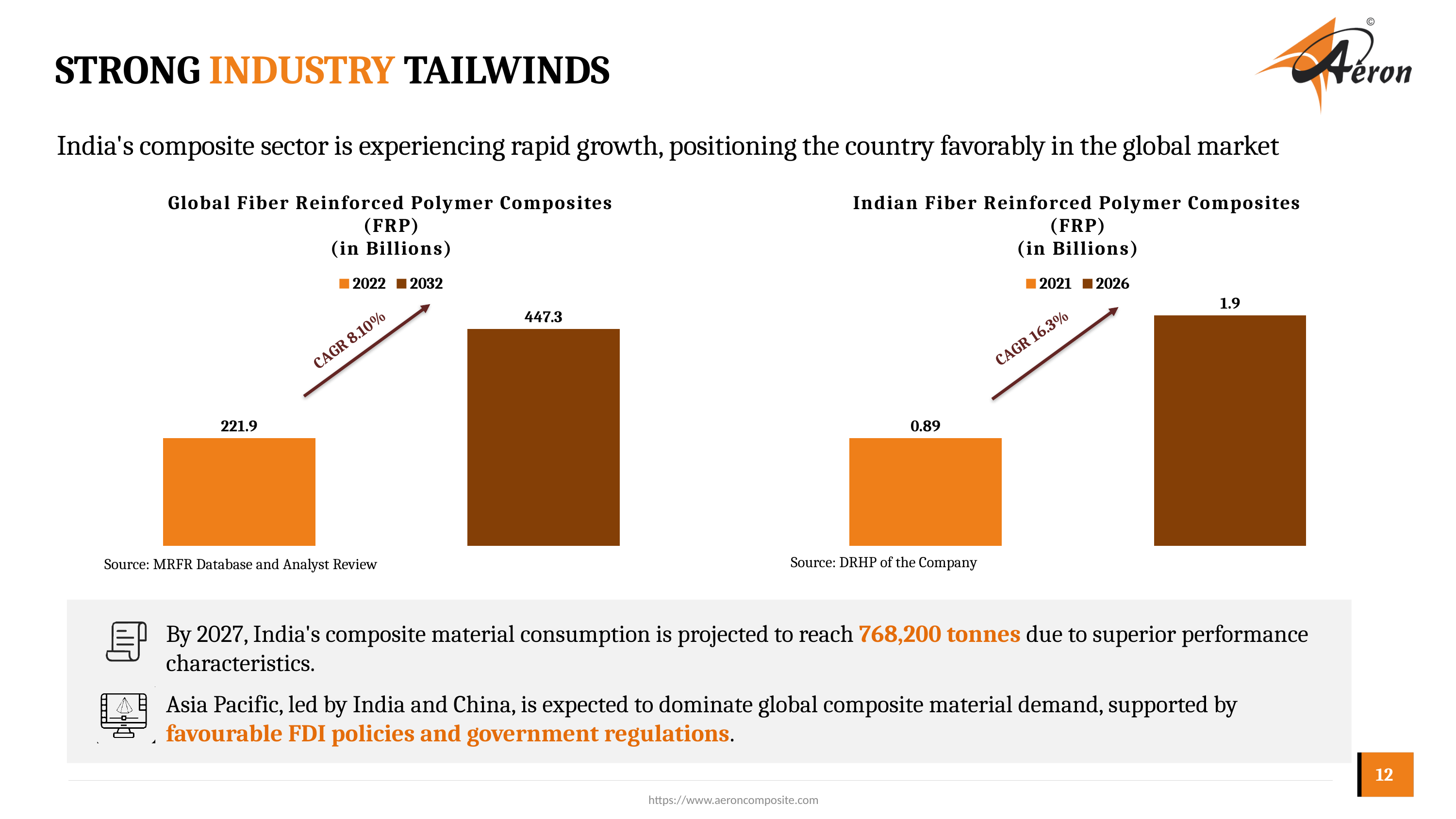
What CAGR is shown on the Global Fiber Reinforced Polymer Composites chart? 8.10% In the Global Fiber Reinforced Polymer Composites chart, what is the value for 2022? 221.9 What CAGR is shown on the Indian Fiber Reinforced Polymer Composites chart? 16.3% In the Indian Fiber Reinforced Polymer Composites chart, which year has the lowest value? 2021 What kind of chart is the Indian Fiber Reinforced Polymer Composites chart? Bar chart In the Global Fiber Reinforced Polymer Composites chart, which year has the higher value, 2022 or 2032? 2032 In the Global Fiber Reinforced Polymer Composites chart, what is the value for 2032? 447.3 In the Indian Fiber Reinforced Polymer Composites chart, what is the value for 2021? 0.89 How many series does the legend of the Global Fiber Reinforced Polymer Composites chart list? 2 In the Global Fiber Reinforced Polymer Composites chart, what is the difference between the 2032 and 2022 values? 225.4 In the Indian Fiber Reinforced Polymer Composites chart, what is the difference between the 2026 and 2021 values? 1.01 In the Indian Fiber Reinforced Polymer Composites chart, what is the value for 2026? 1.9